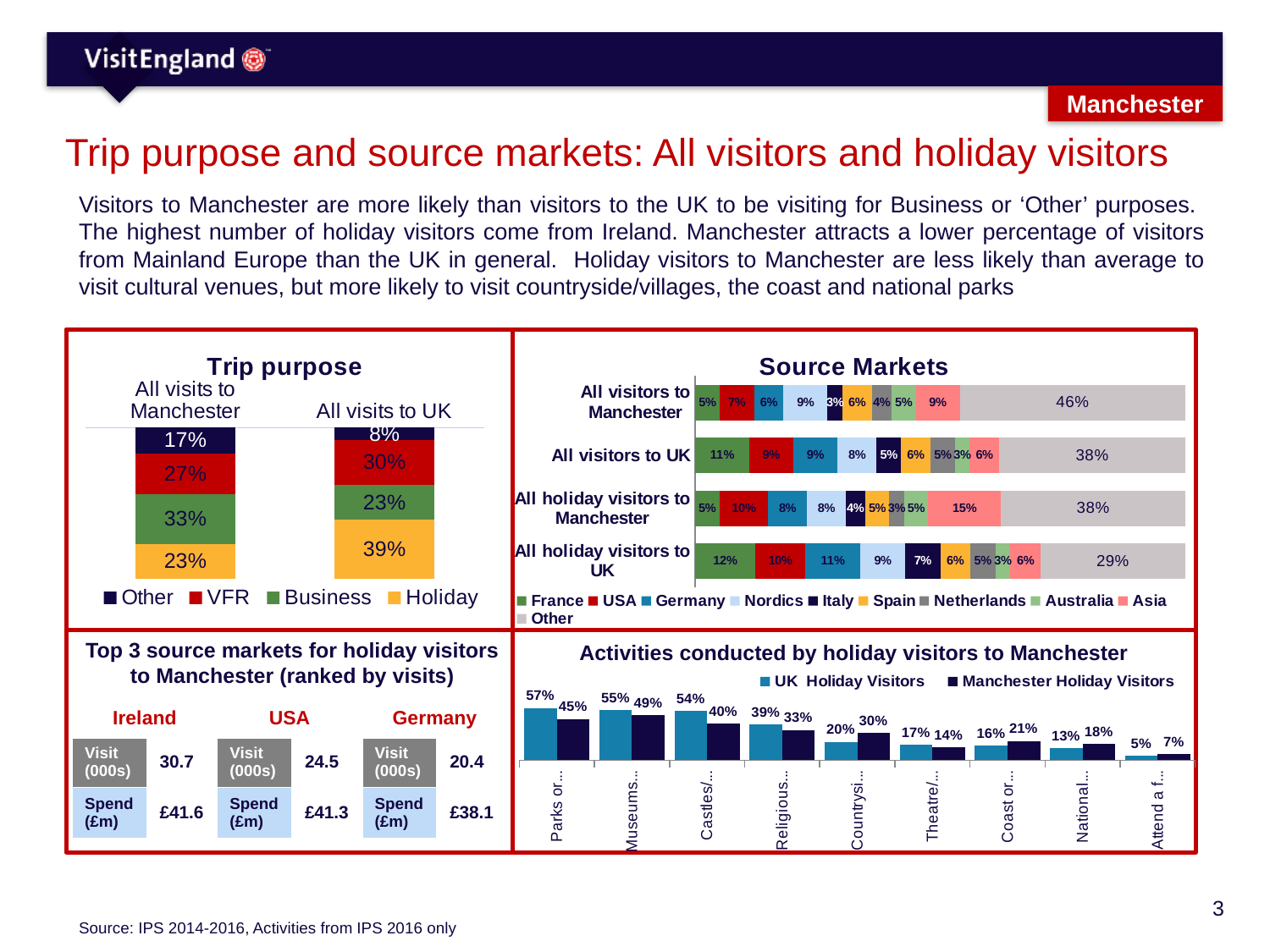
In the Source Markets chart, which of the four bars has the largest France share? All holiday visitors to UK In the Activities conducted by holiday visitors to Manchester chart, which activity has the highest value for UK Holiday Visitors? Parks In the Source Markets chart, what percentage of all holiday visitors to Manchester come from Asia? 15% In the Trip purpose chart, what percentage of all visits to the UK are Holiday visits? 39% In the Trip purpose chart, what is the difference between the Other share for all visits to Manchester and for all visits to the UK? 9 percentage points In the Activities conducted by holiday visitors to Manchester chart, is the Countryside value larger for UK Holiday Visitors or Manchester Holiday Visitors? Manchester Holiday Visitors What kind of chart is the Activities conducted by holiday visitors to Manchester chart? Bar chart In the Activities conducted by holiday visitors to Manchester chart, what is the value for Manchester Holiday Visitors for Parks? 45% How many series does the legend of the Source Markets chart list? 10 How many series does the legend of the Trip purpose chart list? 4 In the Source Markets chart, what percentage of all visitors to Manchester come from the Other category? 46% In the Trip purpose chart, what percentage of all visits to Manchester are for Business? 33%